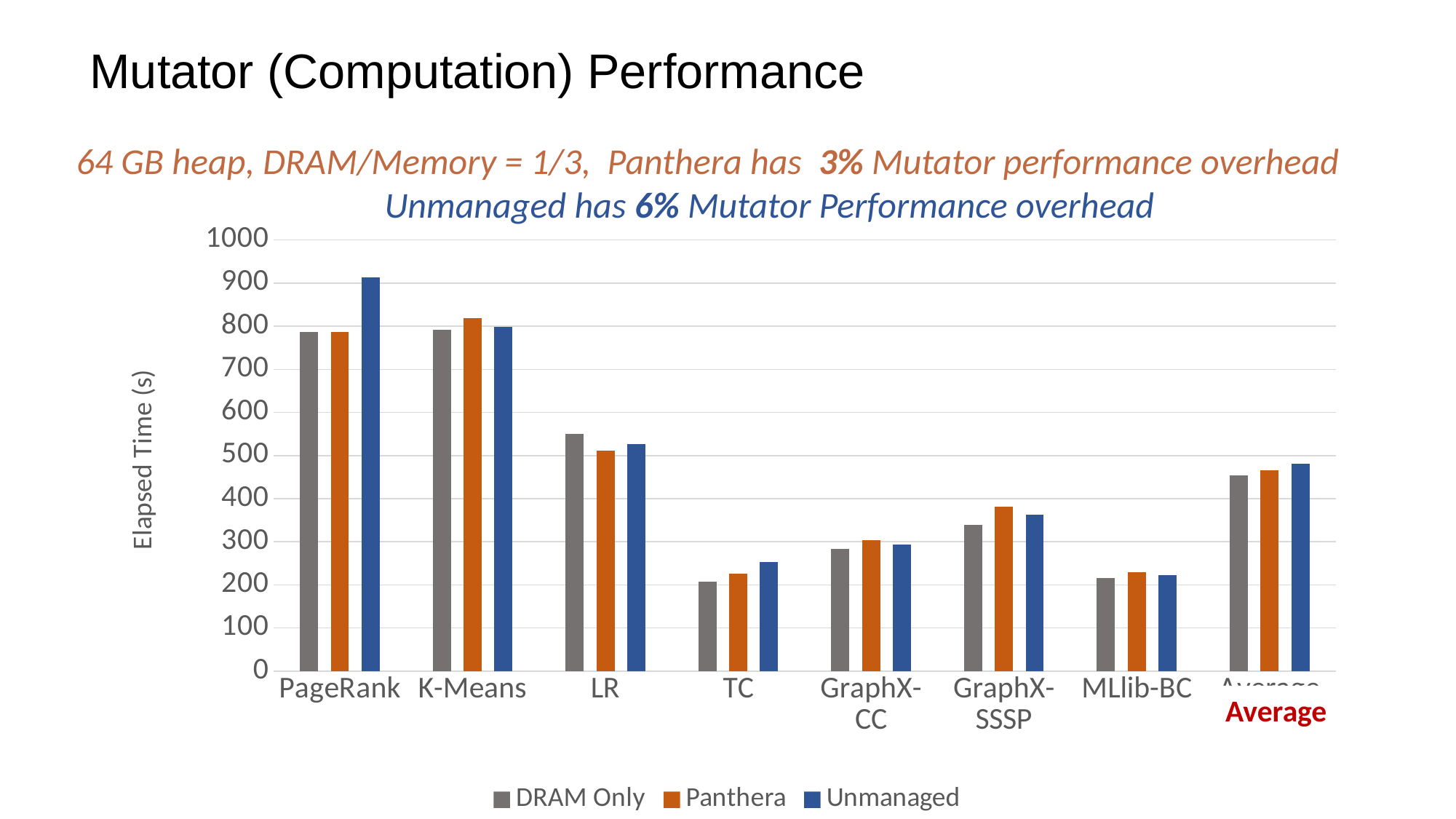
For GraphX-SSSP, which is larger: the DRAM Only value or the Panthera value? Panthera How many series does the legend list? 3 Which category has the highest Panthera value? K-Means For PageRank, which is larger: the DRAM Only value or the Unmanaged value? Unmanaged What kind of chart is shown on the slide? bar chart Which category has the highest Unmanaged value? PageRank Is the Unmanaged value for PageRank greater or less than 800? greater Is the DRAM Only value for LR greater or less than 500? greater Is the Panthera value for TC greater or less than 300? less Which category has the lowest Unmanaged value? MLlib-BC What is the title of the y axis? Elapsed Time (s) How many categories are shown along the x axis? 8